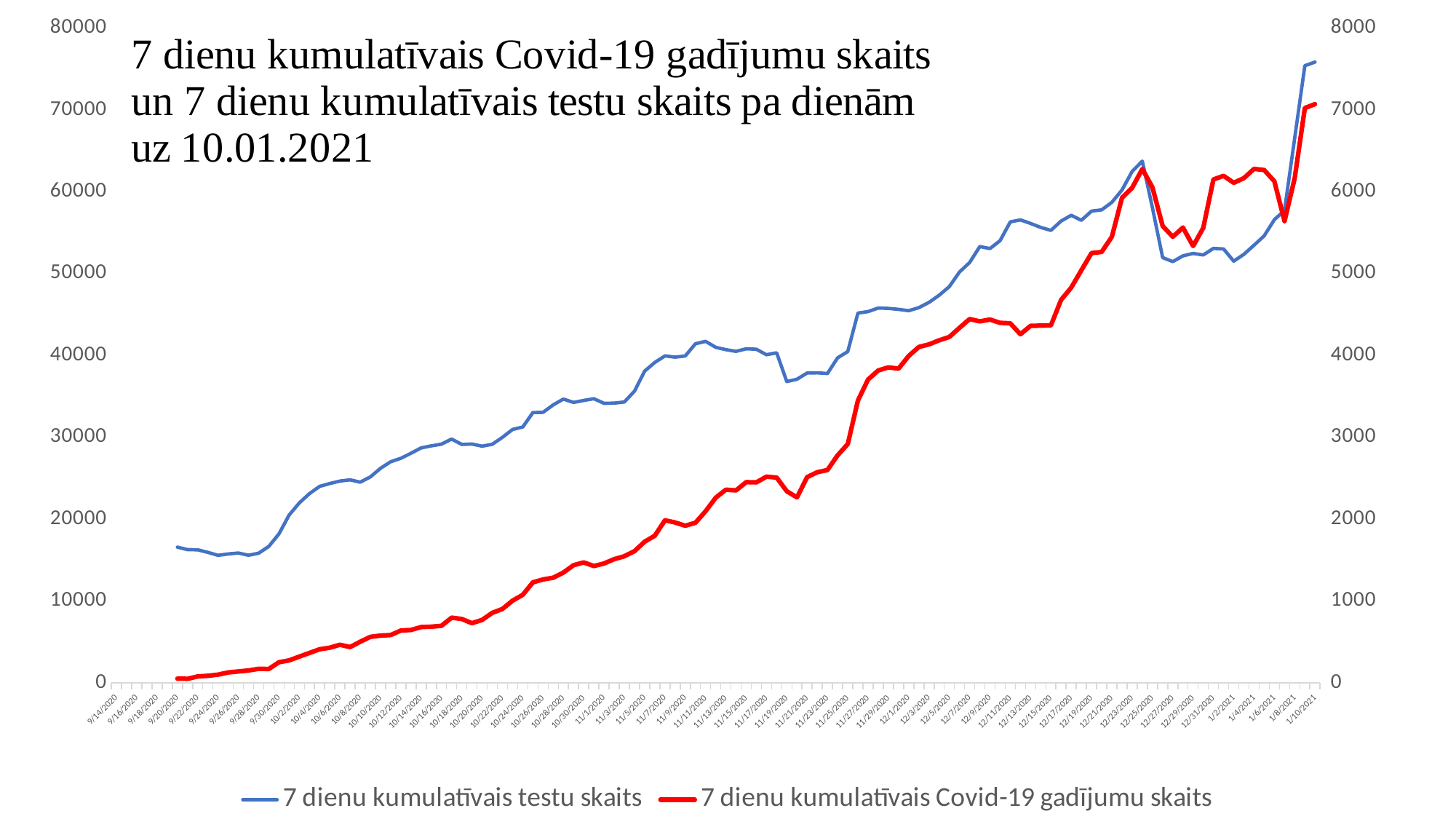
What is the highest value shown on the left vertical axis? 80000 Is the value of '7 dienu kumulatīvais Covid-19 gadījumu skaits' on 1/10/2021 greater or less than 6000 on the right axis? greater Overall, do the values of '7 dienu kumulatīvais testu skaits' rise or fall from 9/20/2020 to 1/10/2021? rise Is the value of '7 dienu kumulatīvais testu skaits' on 1/10/2021 greater or less than 70000? greater Is the value of '7 dienu kumulatīvais Covid-19 gadījumu skaits' on 9/20/2020 greater or less than 1000 on the right axis? less What kind of chart is shown on the slide? line chart How many series does the legend list? 2 Which series is drawn in red? 7 dienu kumulatīvais Covid-19 gadījumu skaits